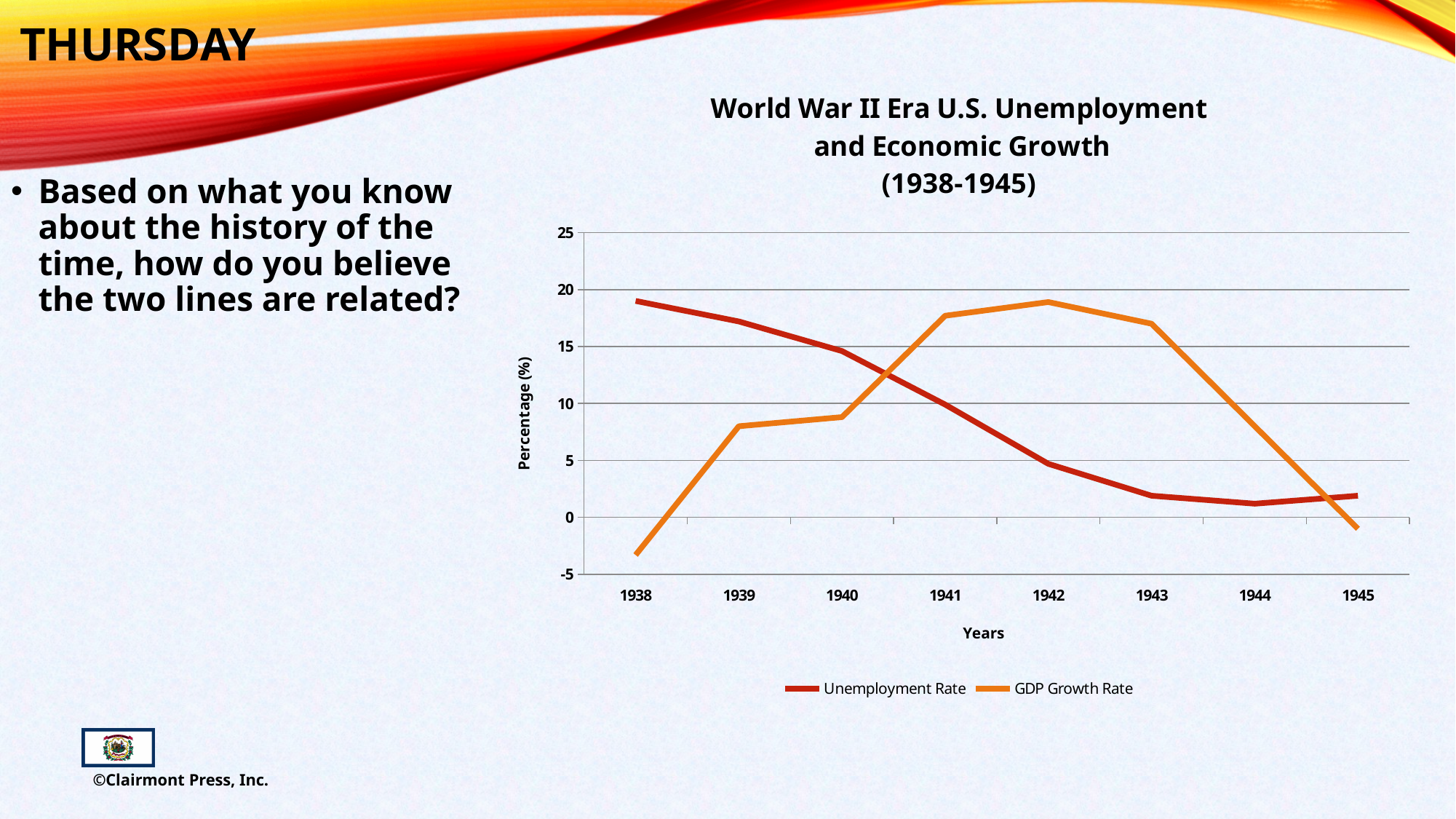
In which year is the GDP Growth Rate lowest? 1938 In 1940, which is larger: the Unemployment Rate or the GDP Growth Rate? Unemployment Rate What kind of chart is shown on the slide? line chart What is the label on the y axis? Percentage (%) Is the Unemployment Rate in 1938 greater or less than 15? greater Does the Unemployment Rate rise or fall from 1938 to 1944? fall In which year is the GDP Growth Rate highest? 1942 How many years are plotted along the x axis? 8 In which year is the Unemployment Rate highest? 1938 Is the GDP Growth Rate in 1938 greater or less than 0? less How many series does the legend list? 2 Is the Unemployment Rate in 1942 greater or less than 10? less